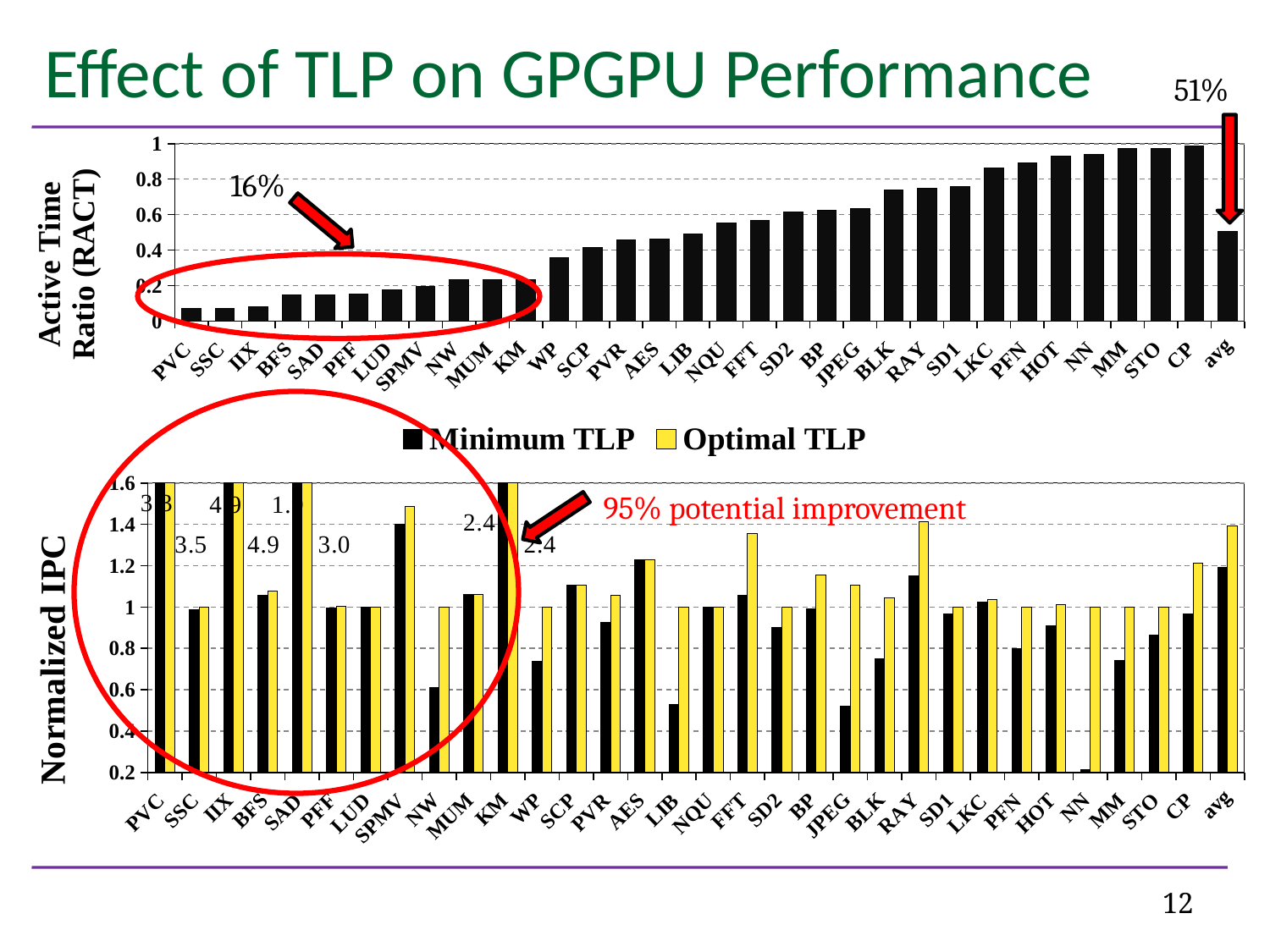
What kind of chart is the top chart (Active Time Ratio)? bar chart How many series does the legend of the bottom chart (Normalized IPC) list? 2 In the top chart (Active Time Ratio), is the value for PVC greater or less than 0.2? less How many categories are shown on the x axis of the top chart (Active Time Ratio)? 32 In the bottom chart (Normalized IPC), is the Minimum TLP value for LIB greater or less than 0.6? less In the top chart (Active Time Ratio), what value is annotated for the avg bar? 51% In the top chart (Active Time Ratio), is the value for BLK greater or less than 0.6? greater In the bottom chart (Normalized IPC), which series has the larger value for avg, Minimum TLP or Optimal TLP? Optimal TLP In the bottom chart (Normalized IPC), what is the Optimal TLP value for KM? 2.4 What are the two series named in the legend of the bottom chart (Normalized IPC)? Minimum TLP and Optimal TLP